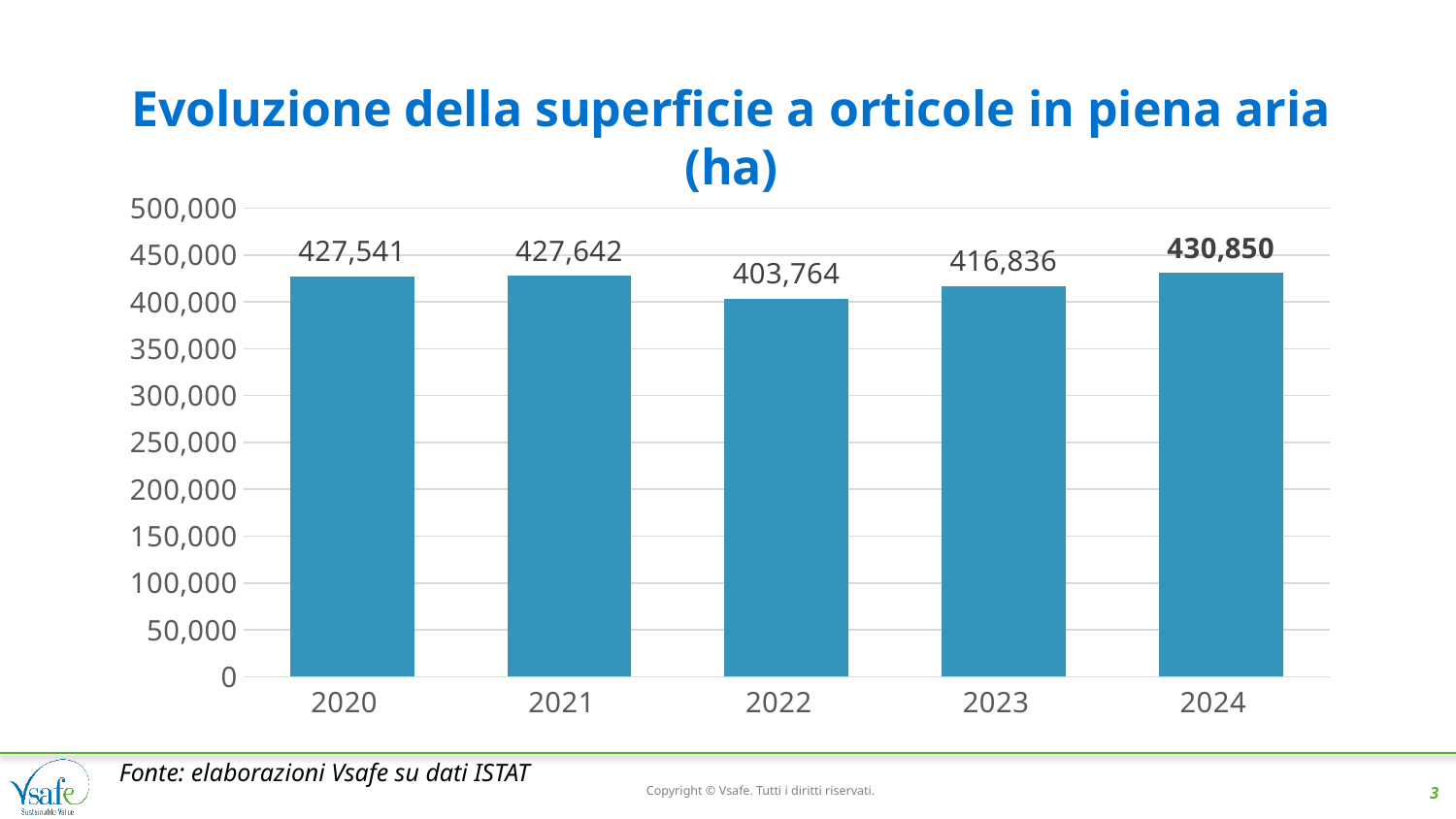
What is the value for 2023? 416,836 What is the difference between the values for 2023 and 2022? 13,072 What is the value for 2024? 430,850 What is the title of the chart? Evoluzione della superficie a orticole in piena aria (ha) Which year has the lowest value? 2022 How many years are shown on the x axis? 5 What is the difference between the values for 2024 and 2022? 27,086 What kind of chart is shown on the slide? bar chart What is the value for 2020? 427,541 Which is larger, the value for 2023 or the value for 2024? 2024 What is the value for 2022? 403,764 Which year has the highest value? 2024